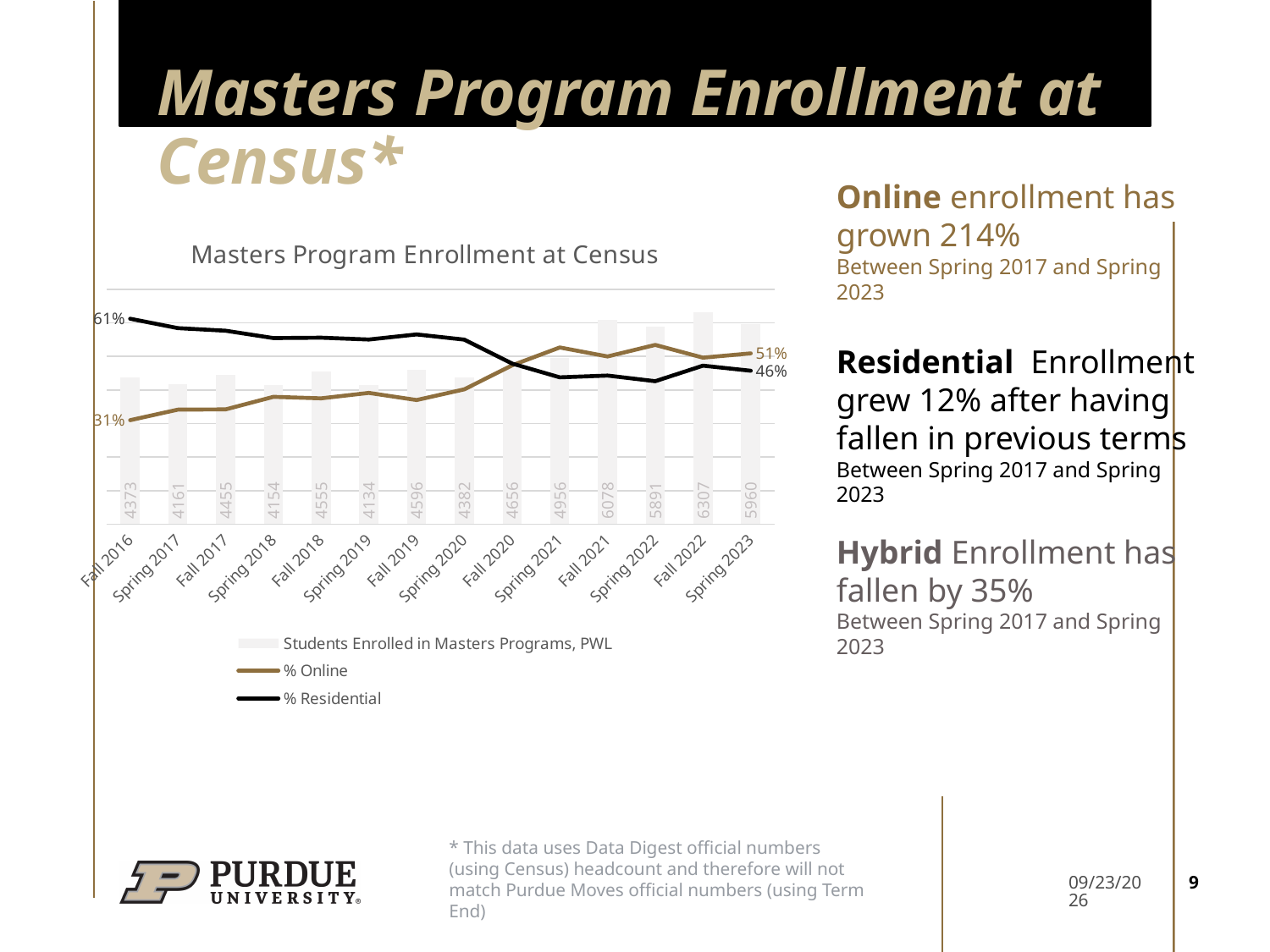
How many series does the chart legend list? 3 Which term has the highest number of students enrolled in Masters Programs, PWL? Fall 2022 Which term has more students enrolled in Masters Programs, PWL: Fall 2021 or Spring 2022? Fall 2021 What is the difference in students enrolled in Masters Programs, PWL between Fall 2022 and Spring 2023? 347 What kind of chart is shown on the slide? Combined bar and line chart Does the % Residential line rise or fall from Fall 2016 to Spring 2023? Fall What is the number of students enrolled in Masters Programs, PWL in Fall 2022? 6307 How many terms are shown on the x axis of the chart? 14 What is the % Online value shown for Spring 2023? 51% Which term has the lowest number of students enrolled in Masters Programs, PWL? Spring 2019 What is the % Residential value shown for Fall 2016? 61% What is the number of students enrolled in Masters Programs, PWL in Spring 2017? 4161